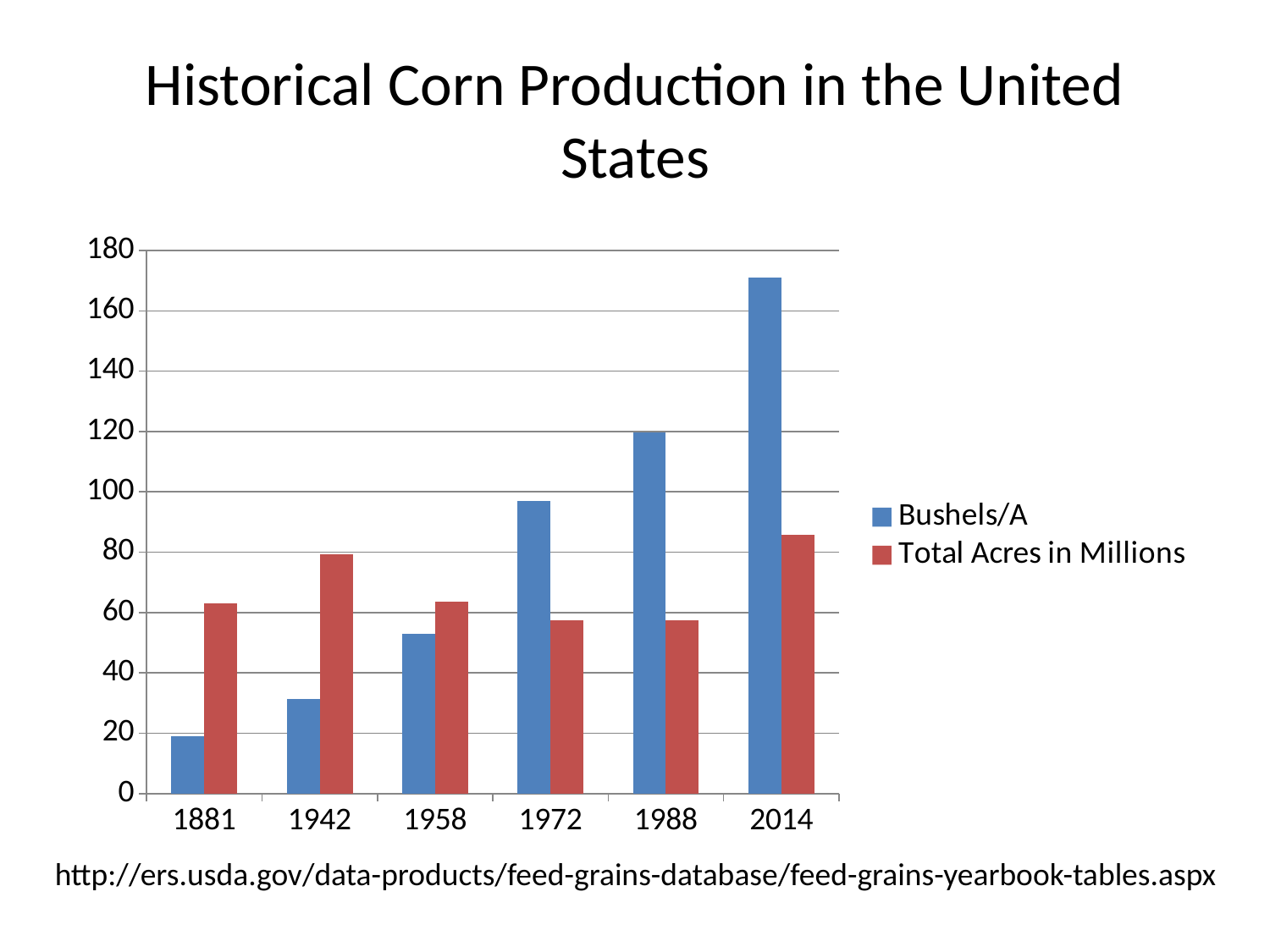
Which year has the lowest Bushels/A value? 1881 In 1881, which is larger: Bushels/A or Total Acres in Millions? Total Acres in Millions Which year has the highest Bushels/A value? 2014 How many years are shown on the x axis? 6 Is the Bushels/A value for 2014 greater or less than 160? greater Which year has the highest Total Acres in Millions value? 2014 What kind of chart is shown on the slide? bar chart What is the title of the chart? Historical Corn Production in the United States Do the Bushels/A values rise or fall from 1881 to 2014? rise How many series does the legend list? 2